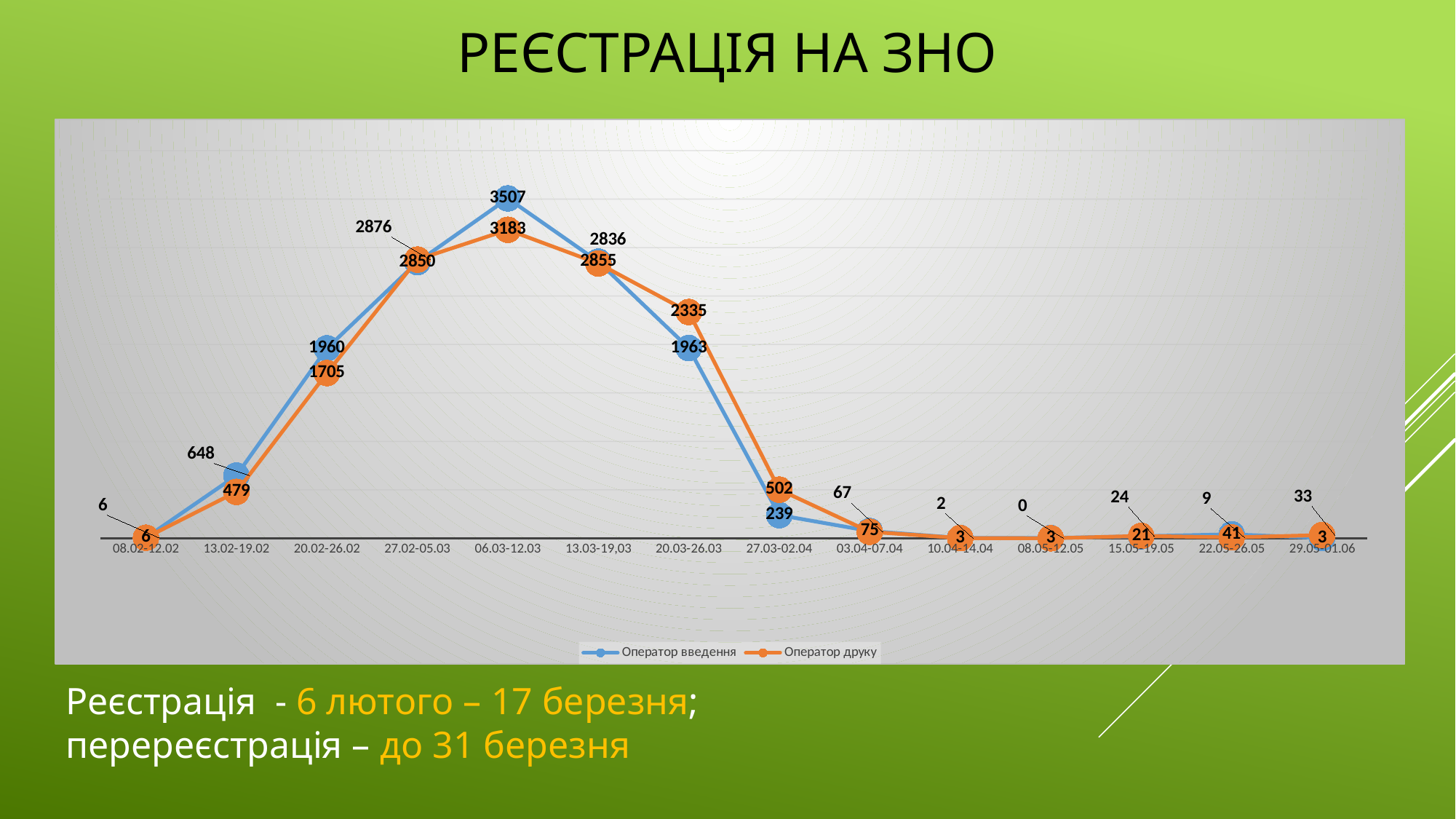
In which period does Оператор введення reach its highest value? 06.03-12.03 How many date periods are shown along the x axis? 14 How many series does the legend list? 2 What is the value for Оператор введення in the period 27.03-02.04? 239 What kind of chart is shown on the slide? Line chart What is the title of the slide containing the chart? РЕЄСТРАЦІЯ НА ЗНО What is the value for Оператор введення in the period 06.03-12.03? 3507 What is the difference between Оператор введення and Оператор друку in the period 06.03-12.03? 324 What is the value for Оператор друку in the period 06.03-12.03? 3183 In the period 20.03-26.03, which series has the larger value, Оператор введення or Оператор друку? Оператор друку Do the values rise or fall from 08.02-12.02 to 06.03-12.03? Rise What is the value for Оператор друку in the period 20.02-26.02? 1705